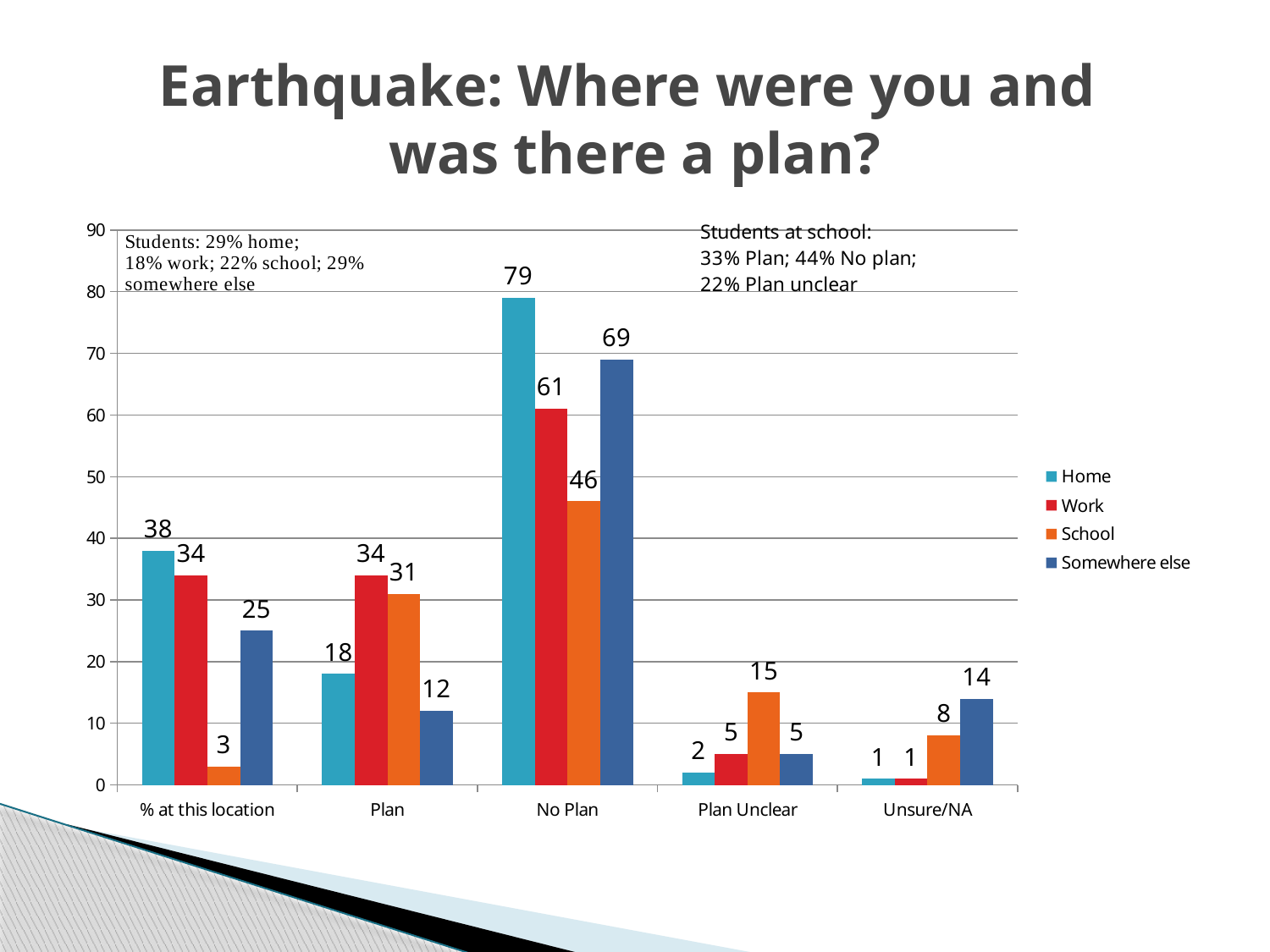
What is the difference between the Home and Work values in the No Plan category? 18 What is the title of the slide? Earthquake: Where were you and was there a plan? How many series does the legend list? 4 What is the difference between the Work and Somewhere else values in the % at this location category? 9 What is the value for School in the % at this location category? 3 What kind of chart is shown on the slide? Bar chart What is the value for Home in the No Plan category? 79 Which series has the lowest value in the No Plan category? School What is the value for Somewhere else in the Plan category? 12 Which is larger in the Unsure/NA category, School or Somewhere else? Somewhere else How many categories are shown on the x axis? 5 Which series has the highest value in the Plan Unclear category? School